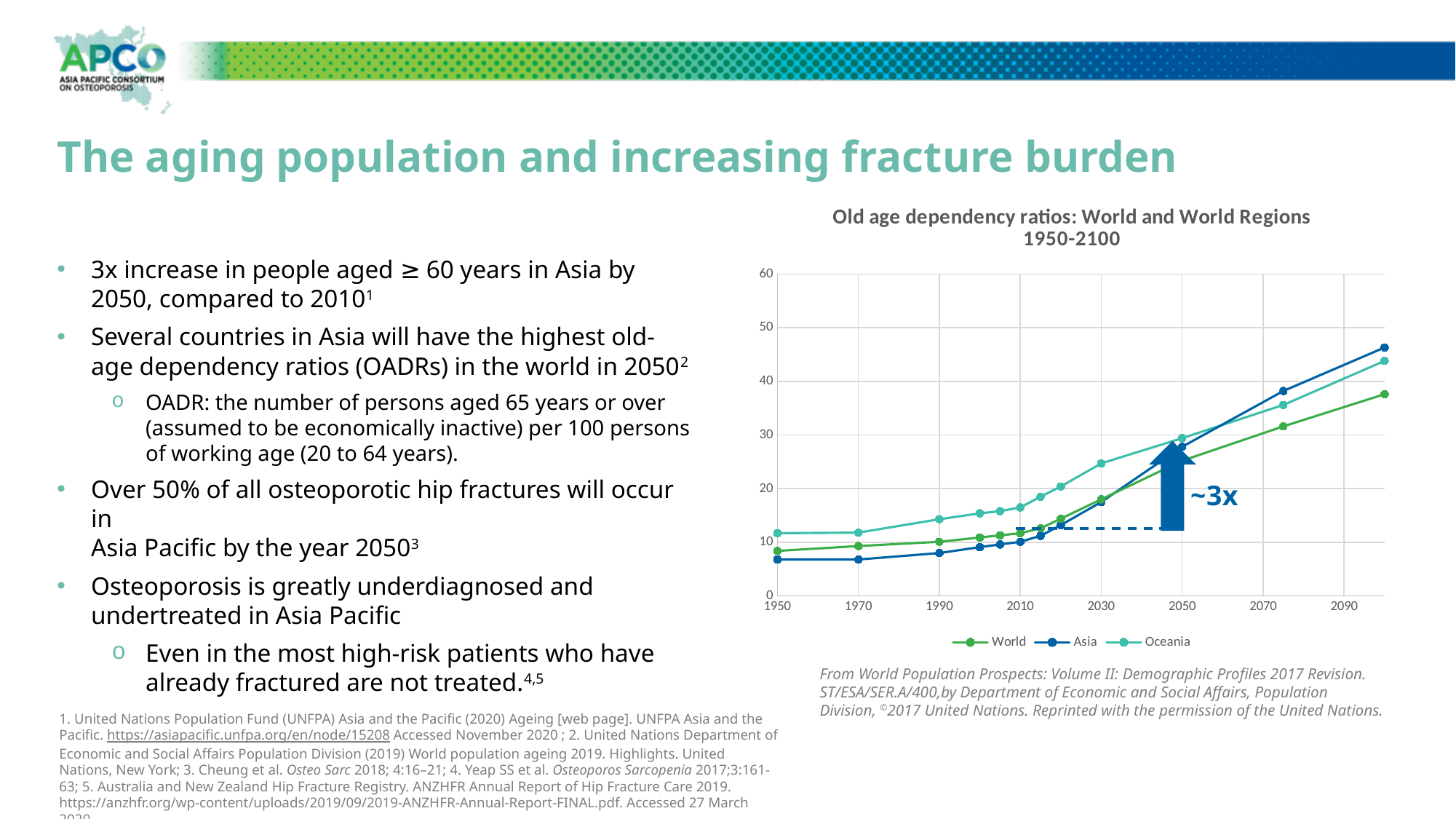
Which series has the highest value in 2100? Asia Which series are listed in the chart legend? World, Asia, Oceania How many series does the chart legend list? 3 Is the value for Asia in 1950 greater or less than 10? less Is the value for Asia in 2100 greater or less than 40? greater What is the title of the chart? Old age dependency ratios: World and World Regions 1950-2100 In 1950, which is larger: the value for Oceania or the value for Asia? Oceania What kind of chart is shown on the slide? line chart Which series has the lowest value in 2100? World Is the value for Oceania in 2030 greater or less than 20? greater Which series has the lowest value in 1950? Asia Do the old age dependency ratios rise or fall from 1950 to 2100? rise